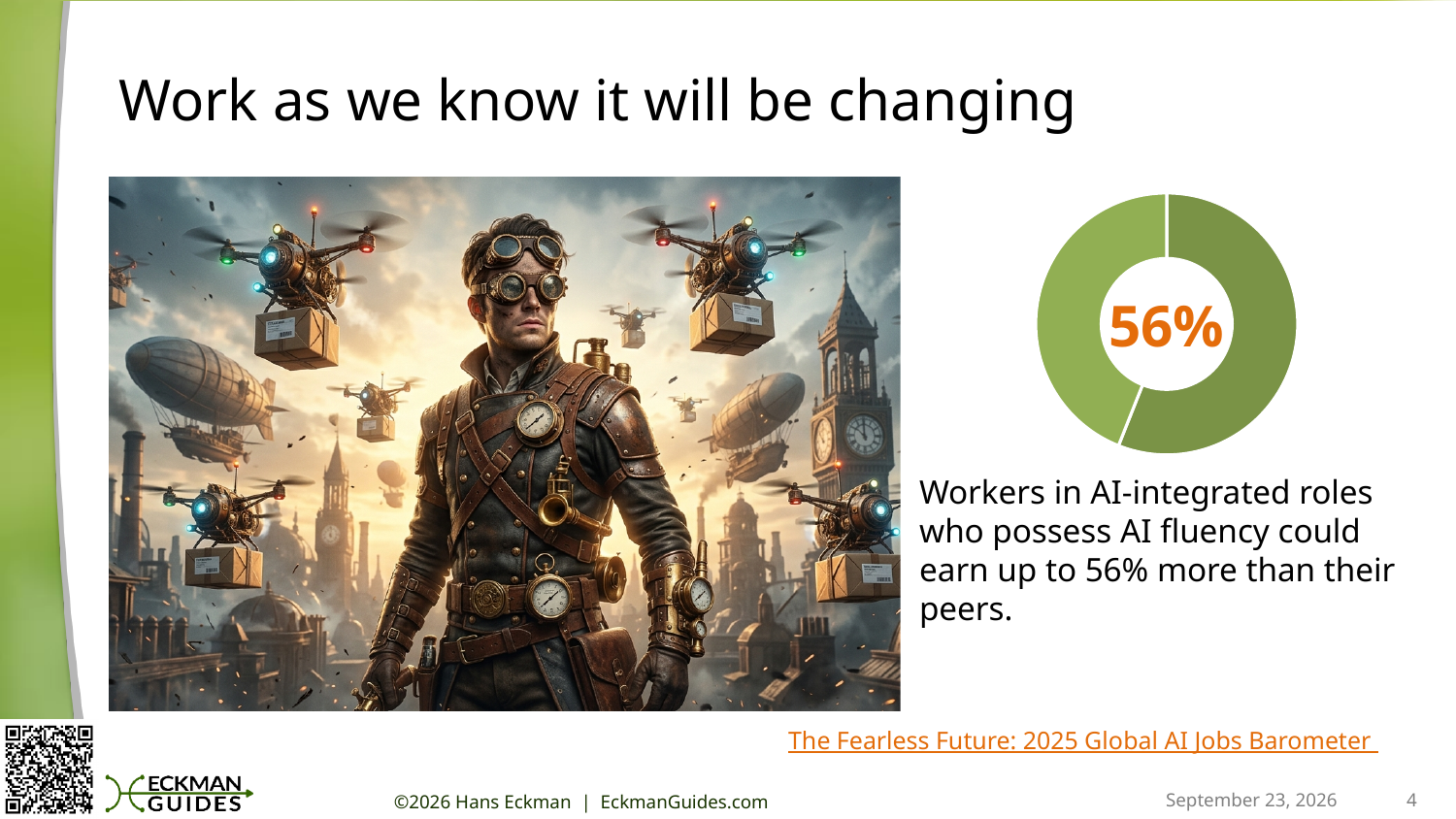
What percentage is printed in the center of the donut chart? 56% Which slice of the donut chart is larger, the darker green one or the lighter green one? The darker green one How many slices does the donut chart have? 2 What colour is the text of the percentage label in the center of the donut chart? Orange Does the donut chart include a legend? No If the highlighted slice of the donut chart is 56%, what share does the remaining slice represent? 44% What kind of chart is shown on the right side of the slide? Donut (pie) chart Is the value highlighted in the donut chart greater or less than 50%? greater